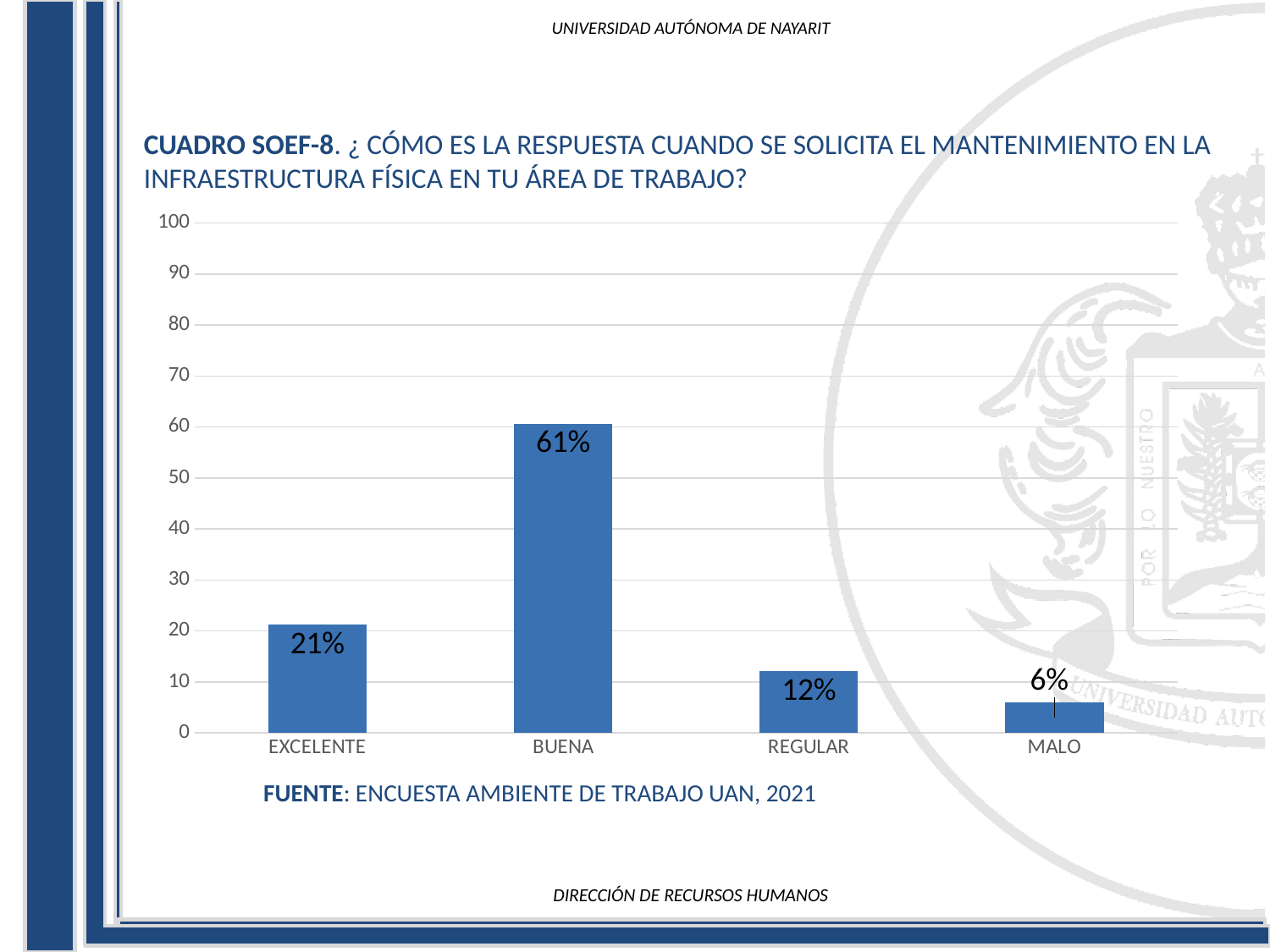
What is the value for EXCELENTE? 21% Which category has the lowest value? MALO Is the value for BUENA greater or less than 50? greater What is the difference between the values for BUENA and EXCELENTE? 40% What is the difference between the values for REGULAR and MALO? 6% Which is larger, the value for EXCELENTE or the value for REGULAR? EXCELENTE What is the value for BUENA? 61% How many categories are shown on the x axis? 4 Which category has the highest value? BUENA What is the value for MALO? 6% What kind of chart is shown on the slide? bar chart What is the value for REGULAR? 12%